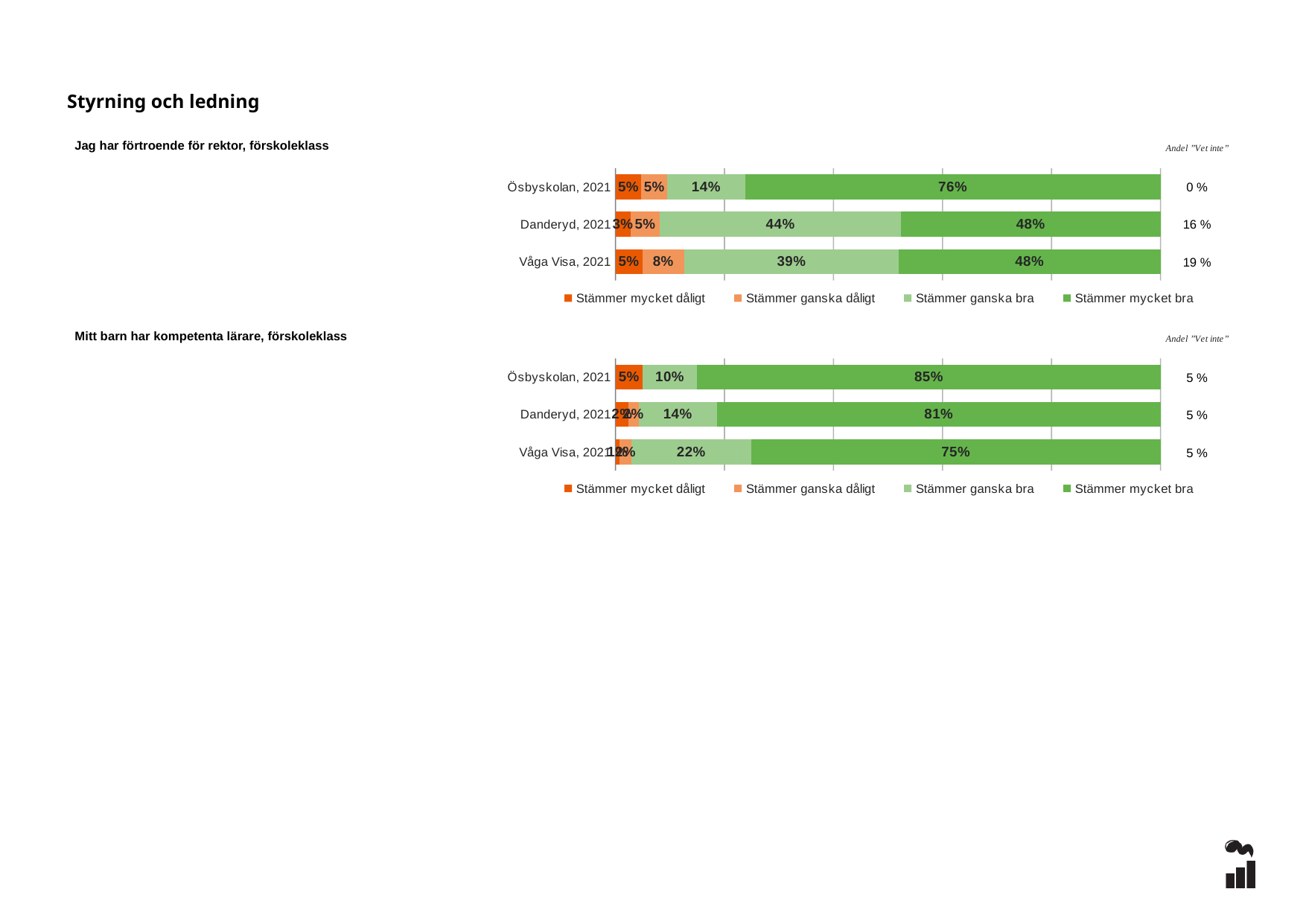
How many series does the legend of the chart 'Mitt barn har kompetenta lärare, förskoleklass' list? 4 In the chart 'Mitt barn har kompetenta lärare, förskoleklass', which category has the lowest 'Stämmer mycket bra' value? Våga Visa, 2021 In the chart 'Jag har förtroende för rektor, förskoleklass', what is the 'Andel "Vet inte"' share shown for Våga Visa, 2021? 19 % In the chart 'Mitt barn har kompetenta lärare, förskoleklass', what is the value of 'Stämmer mycket bra' for Danderyd, 2021? 81% What kind of chart is 'Jag har förtroende för rektor, förskoleklass'? Stacked bar chart In the chart 'Jag har förtroende för rektor, förskoleklass', what is the value of 'Stämmer mycket bra' for Ösbyskolan, 2021? 76% In the chart 'Jag har förtroende för rektor, förskoleklass', what is the value of 'Stämmer ganska dåligt' for Våga Visa, 2021? 8% In the chart 'Jag har förtroende för rektor, förskoleklass', what is the difference between the 'Stämmer ganska bra' values for Danderyd, 2021 and Ösbyskolan, 2021? 30% In the chart 'Jag har förtroende för rektor, förskoleklass', what is the value of 'Stämmer ganska bra' for Danderyd, 2021? 44% In the chart 'Mitt barn har kompetenta lärare, förskoleklass', what is the value of 'Stämmer ganska bra' for Våga Visa, 2021? 22% In the chart 'Mitt barn har kompetenta lärare, förskoleklass', is the 'Stämmer mycket bra' value larger for Ösbyskolan, 2021 or Danderyd, 2021? Ösbyskolan, 2021 In the chart 'Jag har förtroende för rektor, förskoleklass', which category has the highest 'Stämmer mycket bra' value? Ösbyskolan, 2021